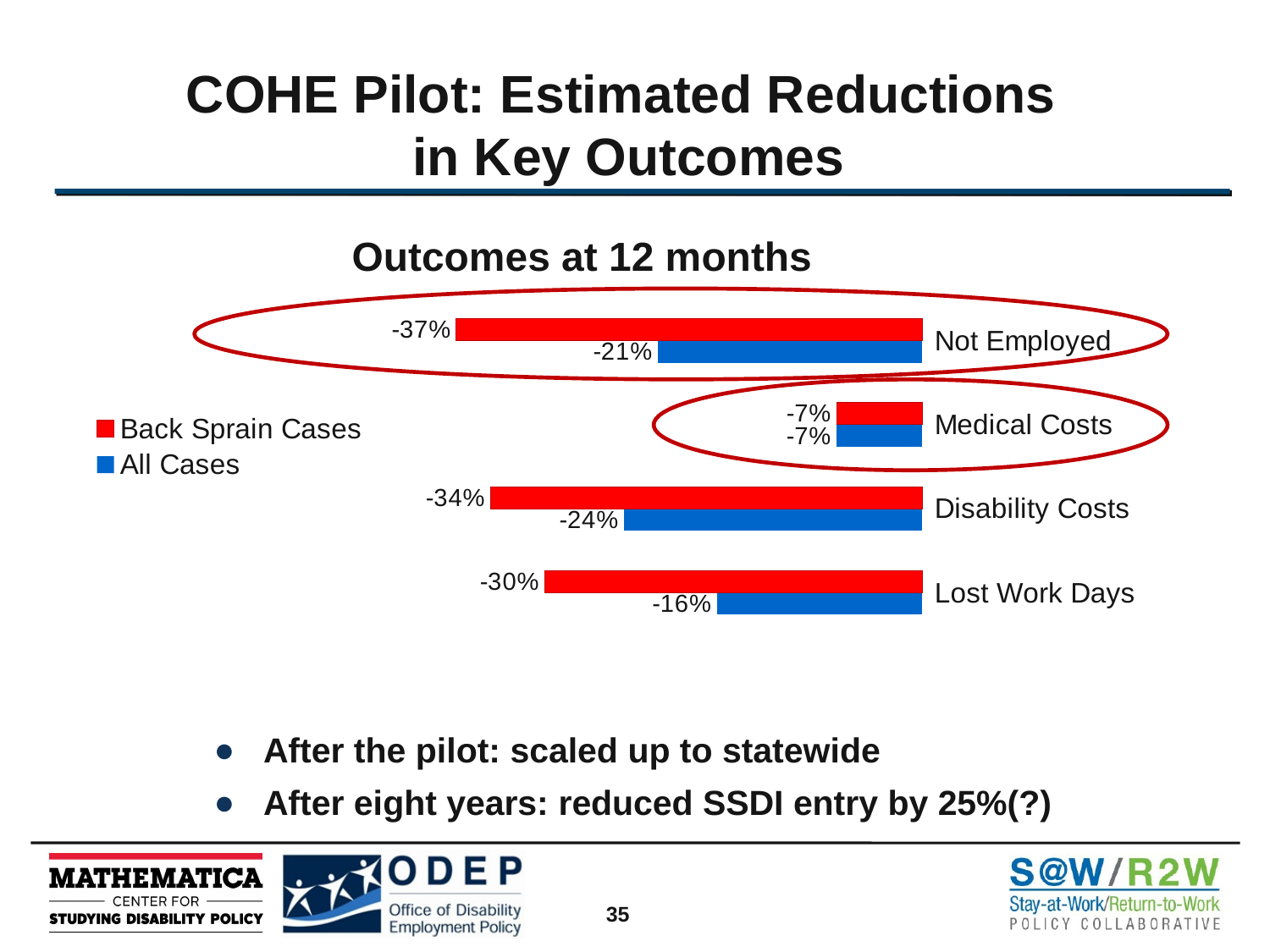
Which category shows the largest reduction for Back Sprain Cases? Not Employed By how many percentage points does the Back Sprain Cases reduction exceed the All Cases reduction for Not Employed? 16 percentage points Which series shows a larger reduction in Lost Work Days, Back Sprain Cases or All Cases? Back Sprain Cases How many series does the legend list? 2 How many outcome categories are shown in the chart? 4 Which category shows the smallest reduction for All Cases? Medical Costs What is the value for All Cases in the Disability Costs category? -24% What is the value for Back Sprain Cases in the Not Employed category? -37% Which category shows the largest reduction for All Cases? Disability Costs What is the value for All Cases in the Lost Work Days category? -16% What is the value for Back Sprain Cases in the Medical Costs category? -7% What type of chart is shown on the slide? Bar chart